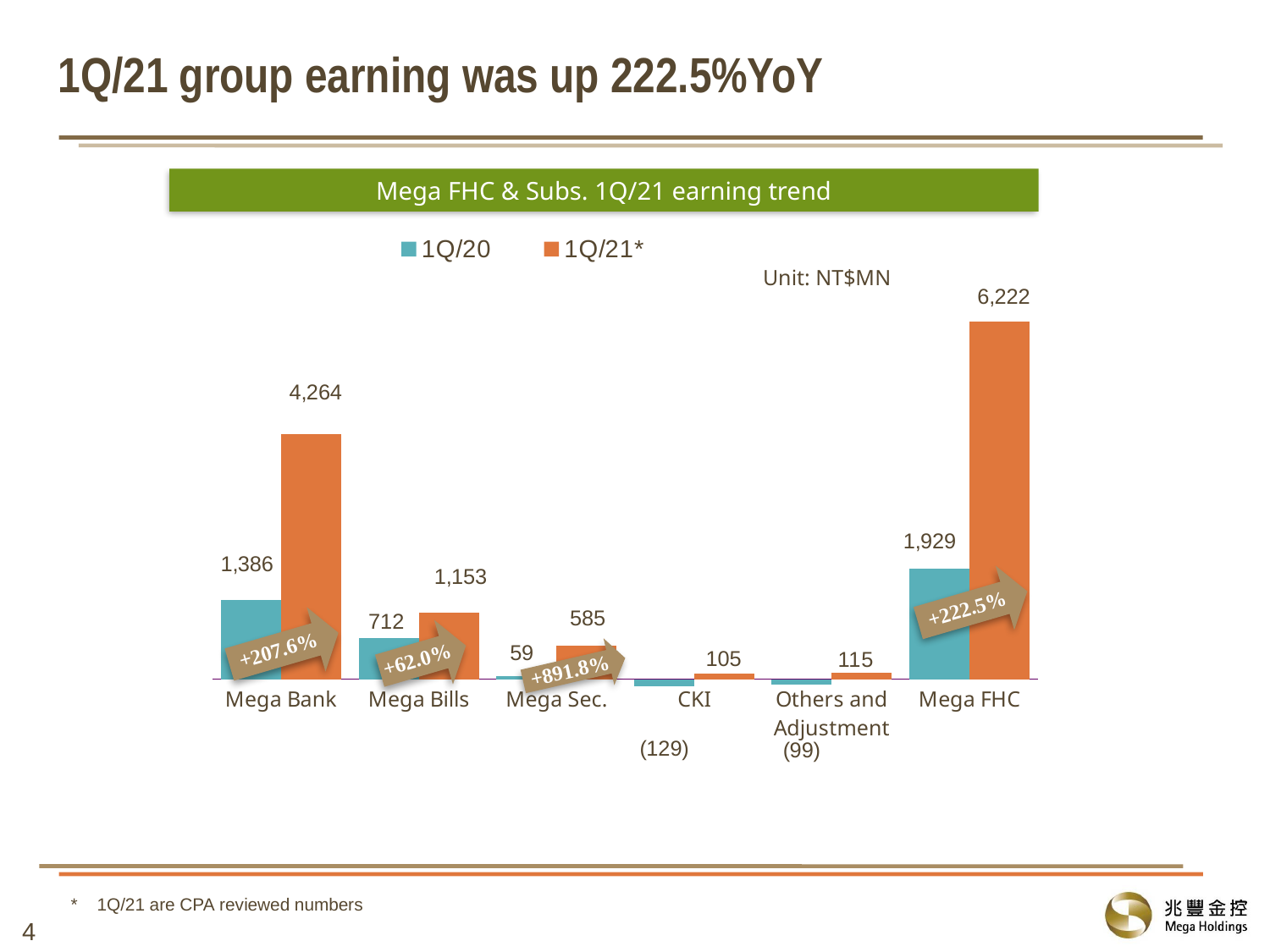
What is the 1Q/20 value for Mega FHC? 1,929 Which is larger: the 1Q/21* value for Mega Bills or the 1Q/20 value for Mega Bank? 1Q/20 value for Mega Bank What is the 1Q/21* value for Mega Sec.? 585 What is the 1Q/21* value for Mega Bank? 4,264 What is the difference between the 1Q/21* and 1Q/20 values for Mega Bills? 441 What is the difference between the 1Q/21* and 1Q/20 values for Mega FHC? 4,293 Which category has the highest 1Q/21* value? Mega FHC What kind of chart is shown on the slide? Bar chart Which category has the lowest 1Q/20 value? CKI What is the 1Q/20 value for CKI? (129) How many series does the legend list? 2 How many categories are shown on the x axis? 6